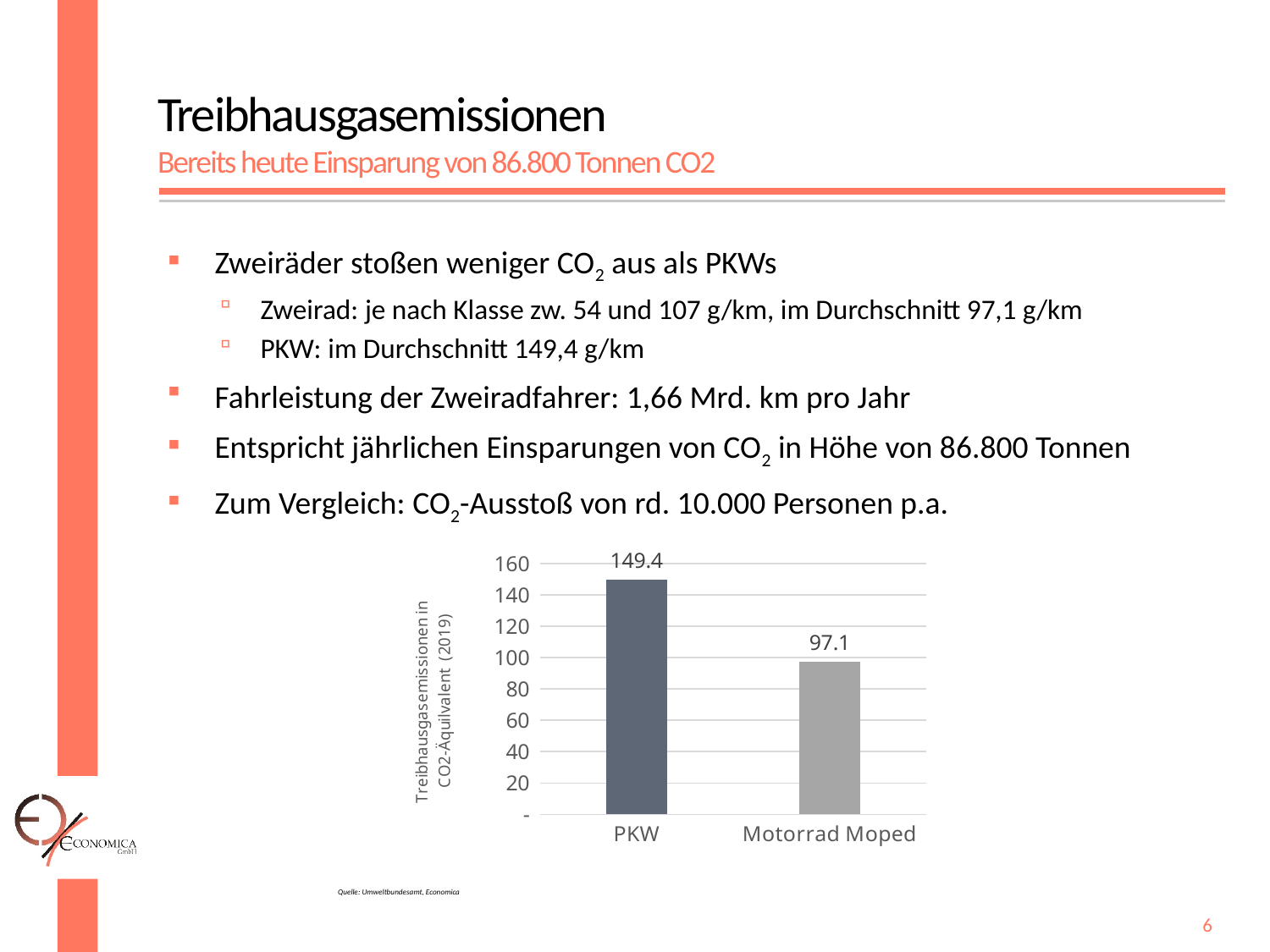
Is the value for PKW greater or less than 140? greater Which is larger, the value for PKW or the value for Motorrad Moped? PKW What is the value for PKW in the chart? 149.4 How many categories are shown in the chart? 2 Is the value for Motorrad Moped greater or less than 100? less What is the highest tick value shown on the vertical axis of the chart? 160 Which category has the lowest value in the chart? Motorrad Moped What is the difference between the values for PKW and Motorrad Moped? 52.3 Which category has the highest value in the chart? PKW What is the value for Motorrad Moped in the chart? 97.1 What kind of chart is shown on the slide? bar chart What is the label of the vertical axis of the chart? Treibhausgasemissionen in CO2-Äquivalent (2019)